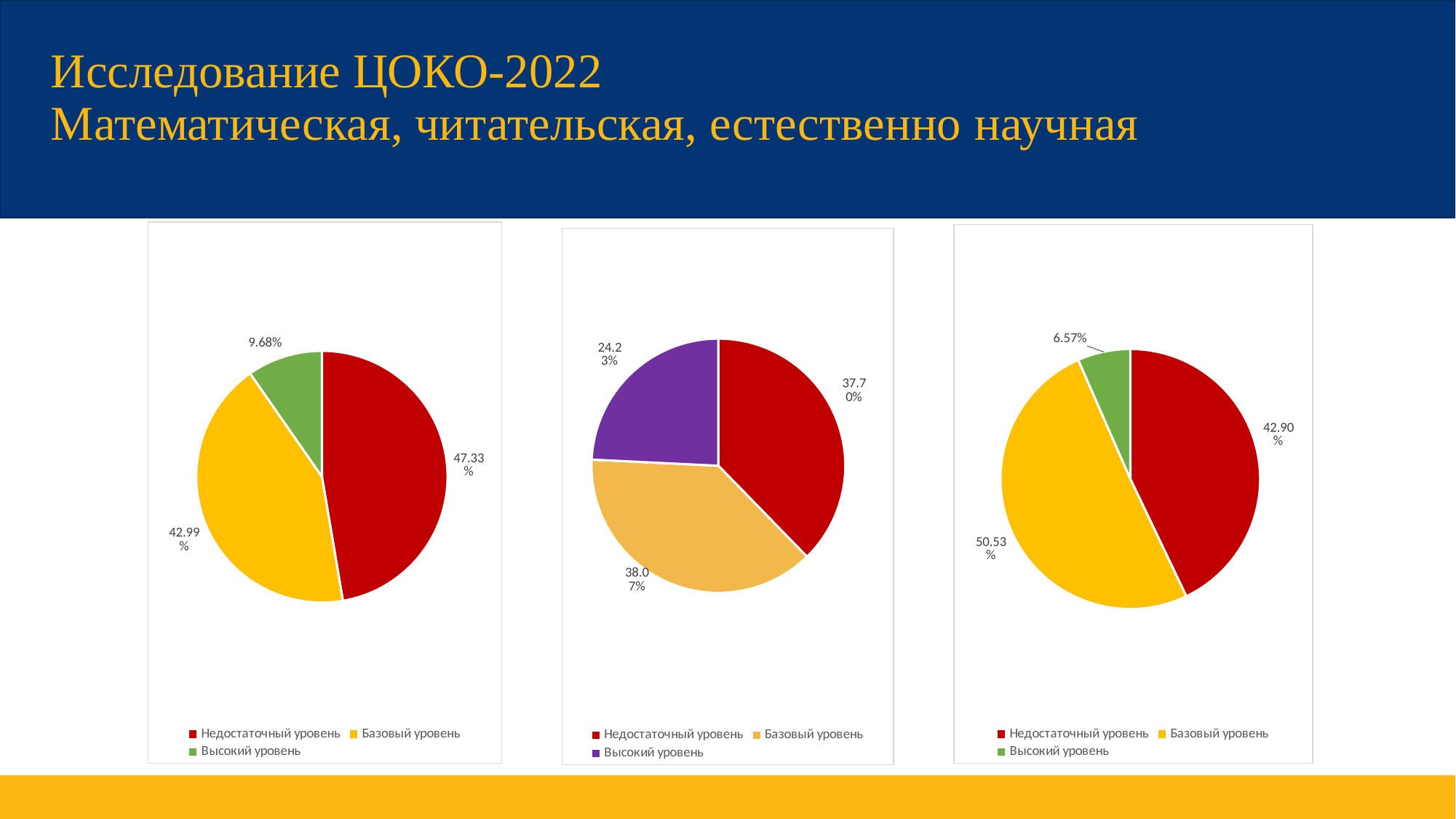
In the right pie chart, what is the difference between the shares for Базовый уровень and Высокий уровень? 43.96% In the left pie chart, what is the share for Недостаточный уровень? 47.33% In the left pie chart, which category has the largest slice? Недостаточный уровень In the right pie chart, which category has the smallest slice? Высокий уровень How many slices does the middle pie chart have? 3 What type of chart is shown on the left of the slide? Pie chart In the right pie chart, what is the share for Базовый уровень? 50.53% In the middle pie chart, what colour is the Высокий уровень slice? Purple In the left pie chart, what is the share for Высокий уровень? 9.68% In the right pie chart, which is larger: Недостаточный уровень or Базовый уровень? Базовый уровень In the left pie chart, what is the difference between the shares for Недостаточный уровень and Базовый уровень? 4.34% In the middle pie chart, what is the share for Высокий уровень? 24.23%